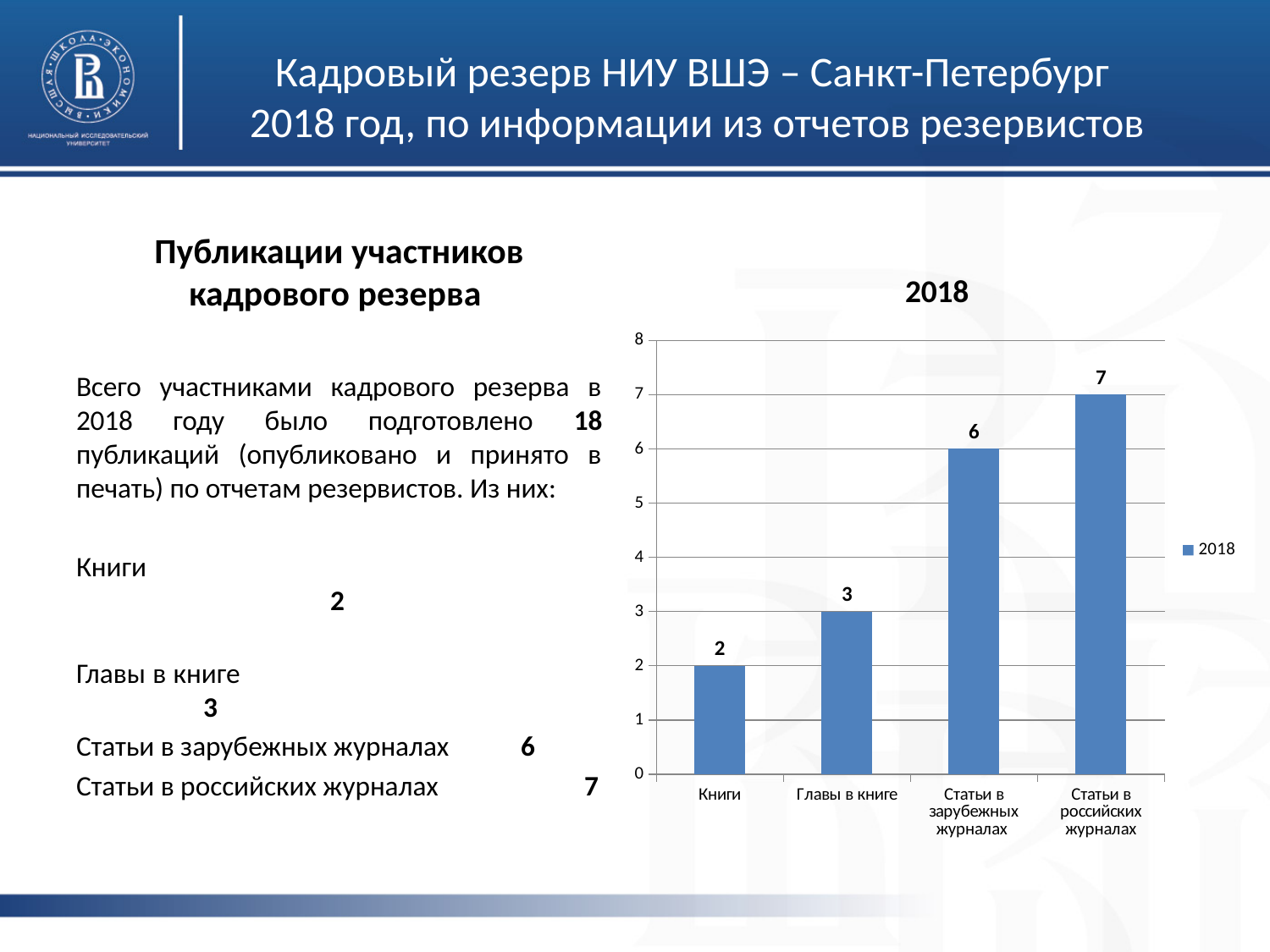
Which category has the lowest value in the chart? Книги Which category has the highest value in the chart? Статьи в российских журналах Which is larger: the value for Главы в книге or the value for Статьи в зарубежных журналах? Статьи в зарубежных журналах What is the value for Книги in the chart? 2 What is the title of the chart? 2018 How many categories are shown on the x axis of the chart? 4 What is the difference between the values for Статьи в российских журналах and Книги? 5 What is the value for Статьи в российских журналах in the chart? 7 How many series does the chart legend list? 1 What is the value for Статьи в зарубежных журналах in the chart? 6 What kind of chart is shown on the slide? bar chart What is the value for Главы в книге in the chart? 3